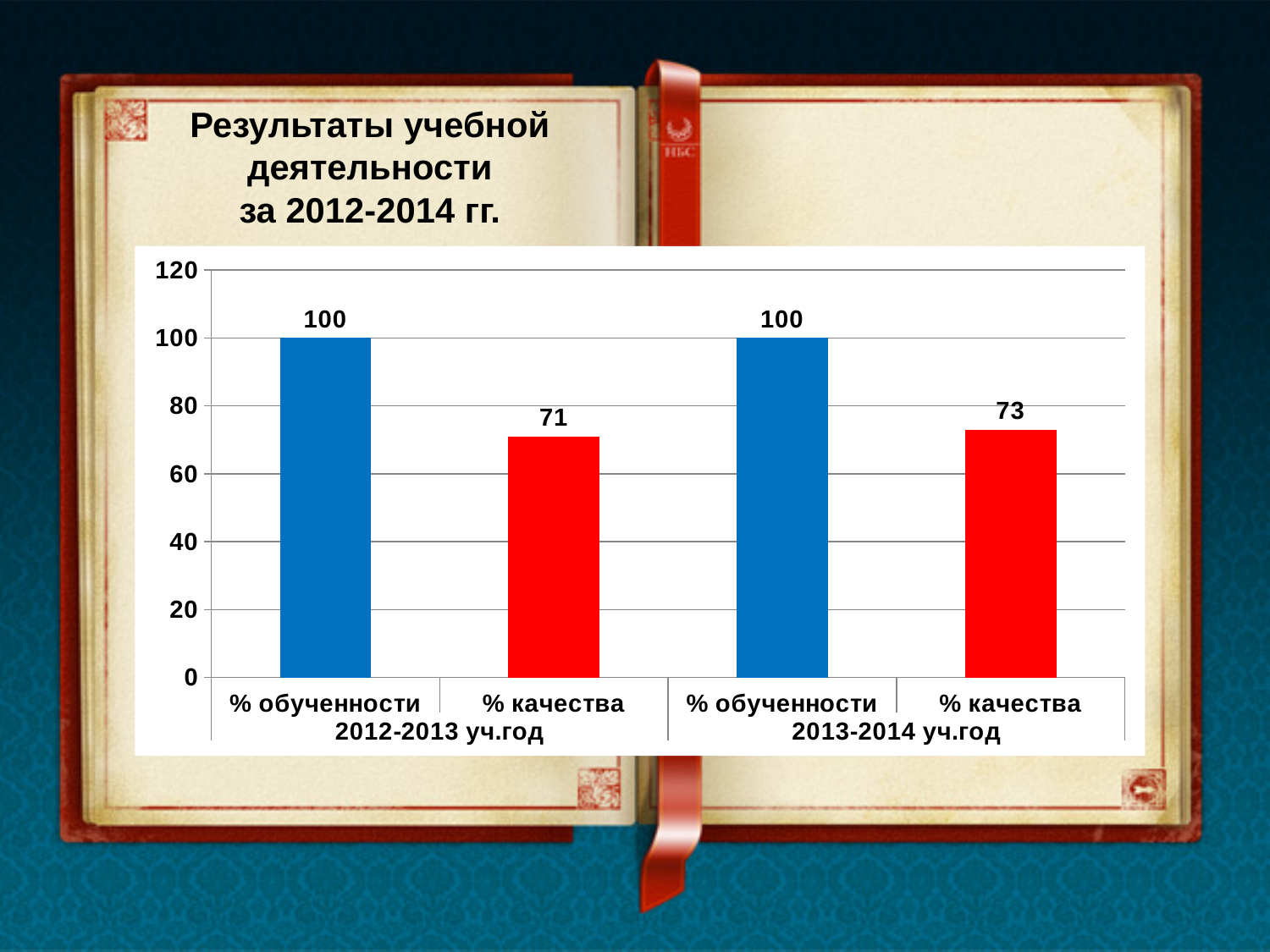
Which category has the lowest value on the chart? % качества 2012-2013 уч.год What is the difference between % качества in 2013-2014 уч.год and % качества in 2012-2013 уч.год? 2 Which is larger: % качества in 2012-2013 уч.год or % качества in 2013-2014 уч.год? % качества in 2013-2014 уч.год What is the difference between % обученности and % качества in 2012-2013 уч.год? 29 What kind of chart is shown on the slide? bar chart What is the value for % обученности in 2013-2014 уч.год? 100 What is the value for % качества in 2013-2014 уч.год? 73 Is the value for % качества in 2012-2013 уч.год greater or less than 80? less What is the title of the slide above the chart? Результаты учебной деятельности за 2012-2014 гг. What is the value for % качества in 2012-2013 уч.год? 71 Did the value for % качества rise or fall from 2012-2013 уч.год to 2013-2014 уч.год? rise How many bars are plotted on the chart? 4